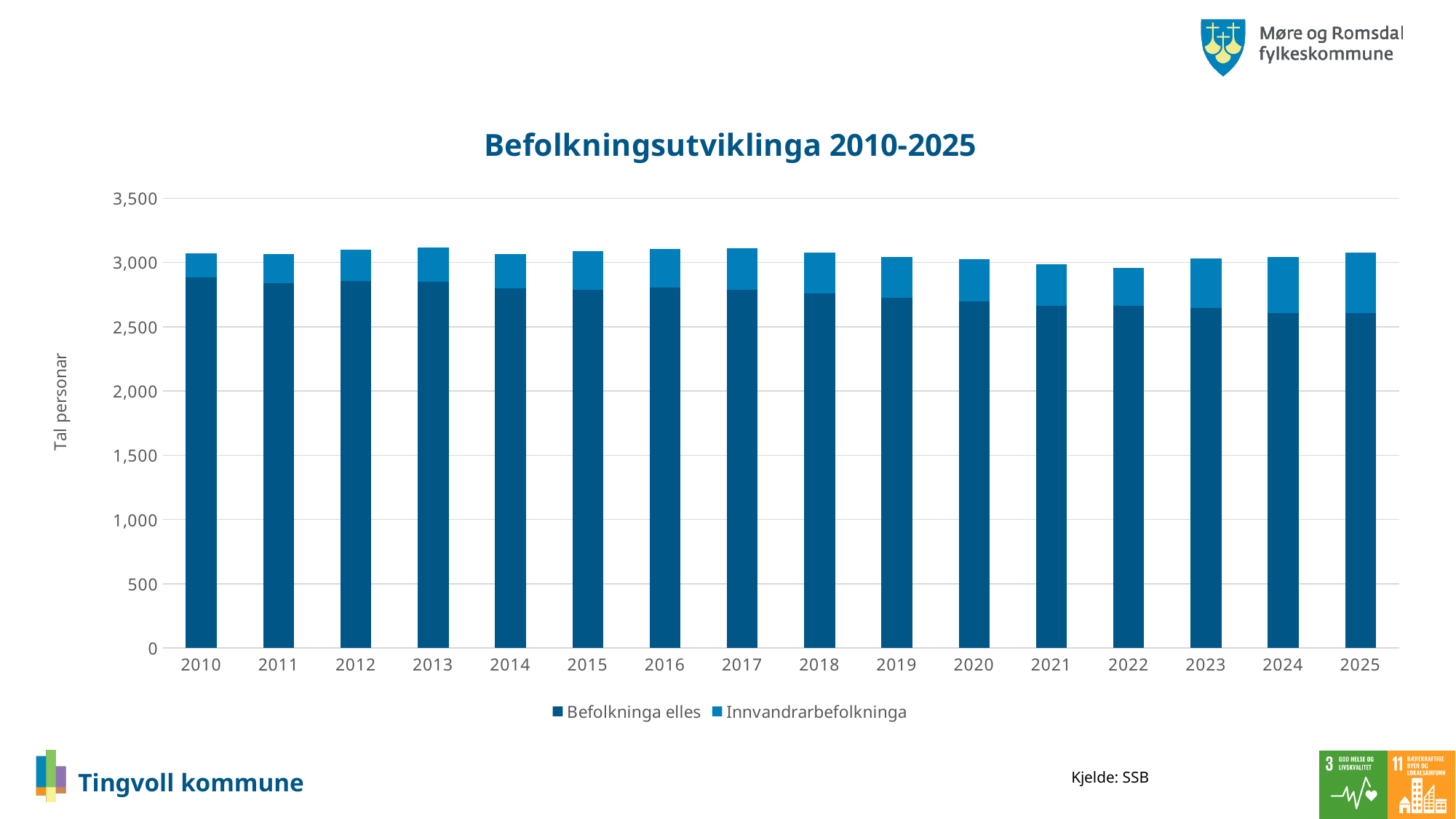
Is the value for Befolkninga elles in 2010 greater or less than 2,500? greater How many years are shown on the x axis of the chart? 16 What is the label on the vertical axis? Tal personar Which year has a larger value for Innvandrarbefolkninga, 2010 or 2025? 2025 Is the total bar height for 2010 greater or less than 3,000? greater Which year has a larger value for Befolkninga elles, 2010 or 2025? 2010 Is the value for Befolkninga elles in 2025 greater or less than 3,000? less What is the title of the chart? Befolkningsutviklinga 2010-2025 What kind of chart is shown on the slide? Stacked bar chart How many series does the legend list? 2 Does the Befolkninga elles series generally rise or fall from 2010 to 2025? fall Does the Innvandrarbefolkninga series generally rise or fall from 2010 to 2025? rise